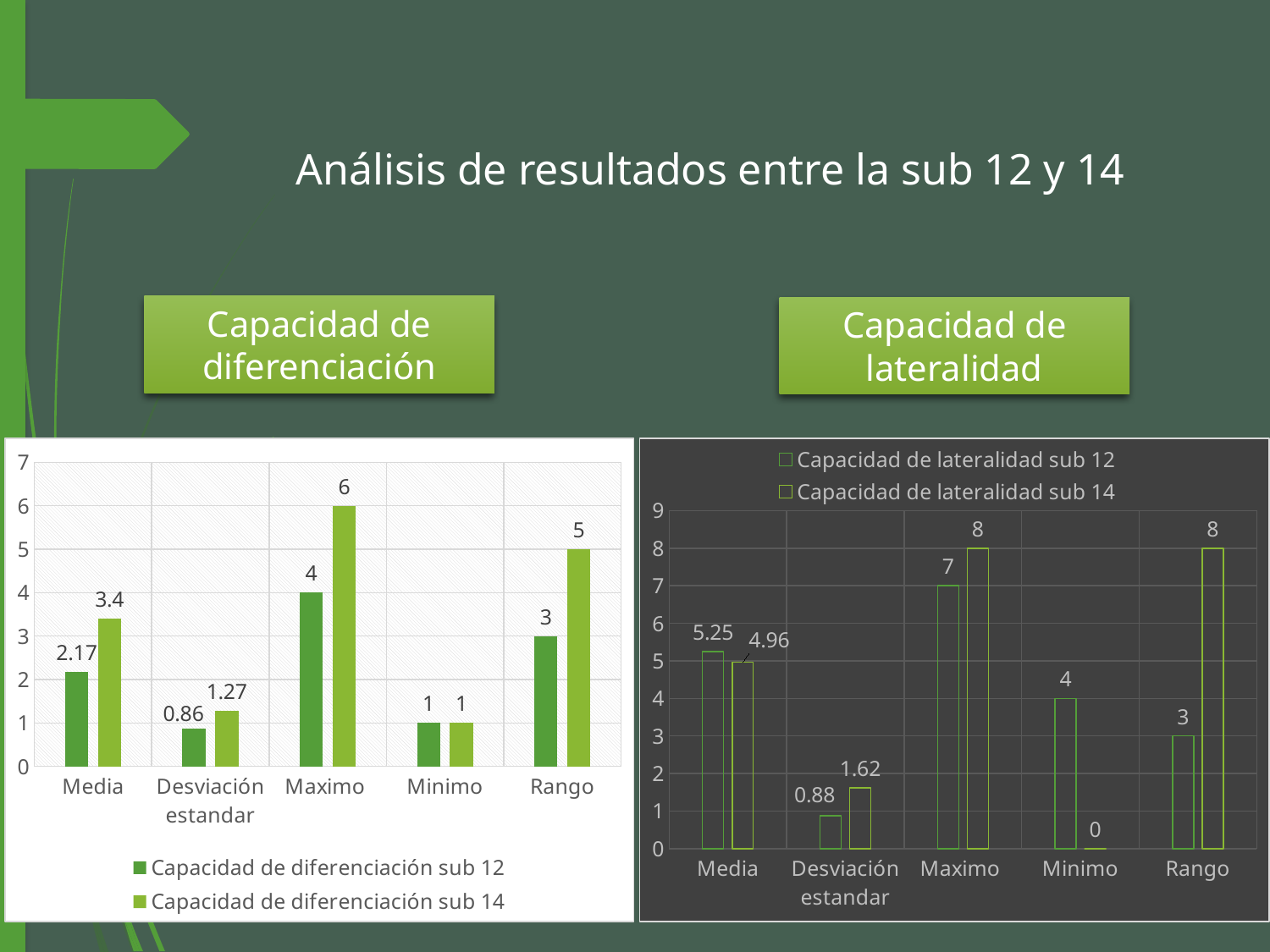
In the Capacidad de diferenciación chart, what is the difference between the Rango values for sub 14 and sub 12? 2 How many series does the legend of the Capacidad de lateralidad chart list? 2 In the Capacidad de lateralidad chart, what is the difference between the Rango values for sub 14 and sub 12? 5 In the Capacidad de diferenciación chart, which category has the highest value for Capacidad de diferenciación sub 14? Maximo In the Capacidad de lateralidad chart, what is the value of Media for Capacidad de lateralidad sub 12? 5.25 In the Capacidad de lateralidad chart, what is the value of Minimo for Capacidad de lateralidad sub 14? 0 In the Capacidad de diferenciación chart, what is the value of Media for Capacidad de diferenciación sub 14? 3.4 In the Capacidad de lateralidad chart, which is larger for Media: Capacidad de lateralidad sub 12 or sub 14? Capacidad de lateralidad sub 12 In the Capacidad de diferenciación chart, what is the value of Desviación estandar for Capacidad de diferenciación sub 12? 0.86 In the Capacidad de lateralidad chart, which category has the lowest value for Capacidad de lateralidad sub 12? Desviación estandar In the Capacidad de diferenciación chart, how many categories are shown on the x axis? 5 What type of chart is the Capacidad de diferenciación chart? Bar chart